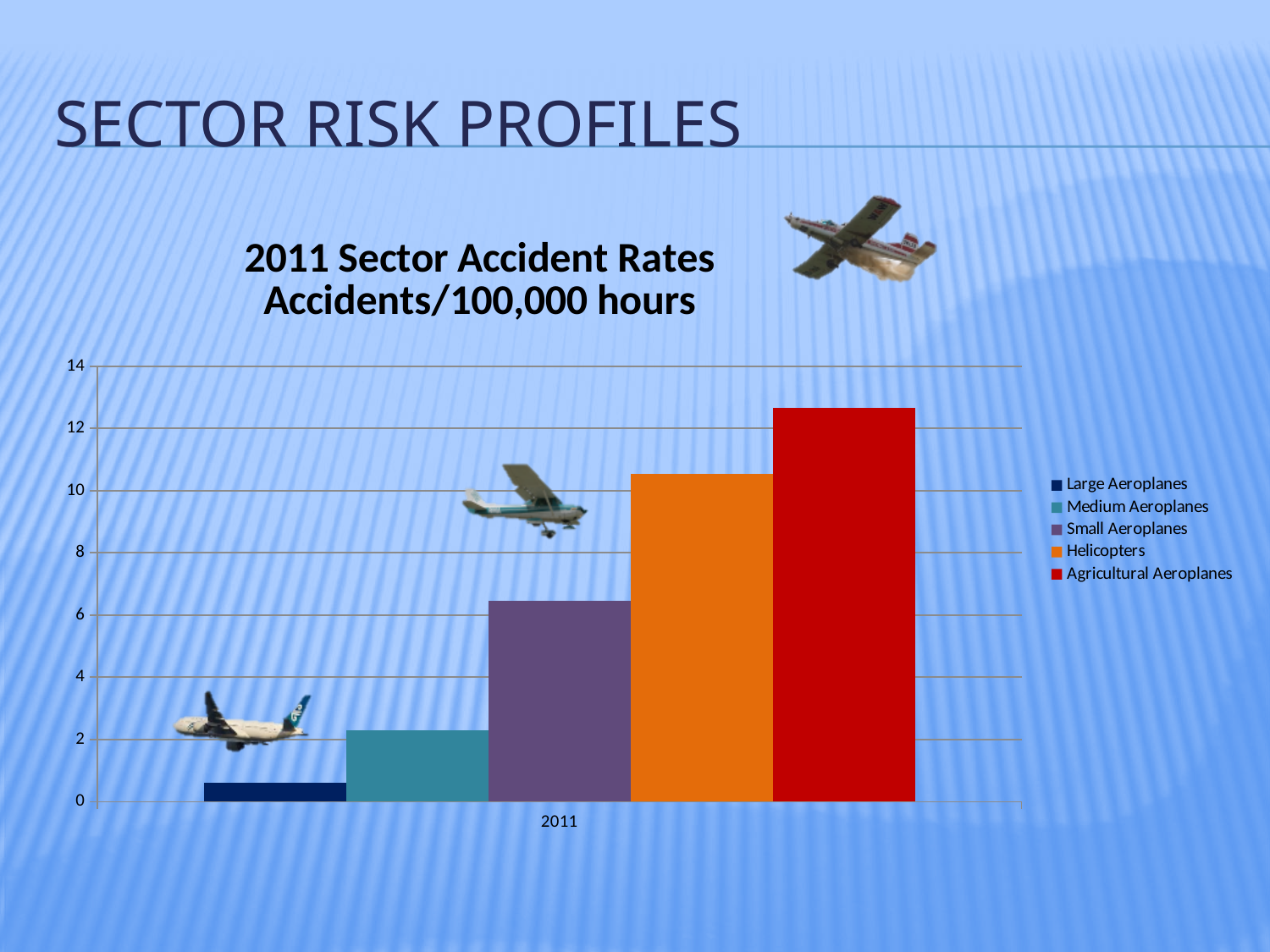
Is the value for Small Aeroplanes greater or less than 8? less How many series does the legend list? 5 Is the value for Helicopters greater or less than 10? greater What kind of chart is shown on the slide? bar chart Which series has the lowest accident rate in 2011? Large Aeroplanes Which is larger, the accident rate for Helicopters or for Small Aeroplanes? Helicopters How many categories are shown on the x axis? 1 What is the title of the chart? 2011 Sector Accident Rates Accidents/100,000 hours Which series has the highest accident rate in 2011? Agricultural Aeroplanes Is the value for Large Aeroplanes greater or less than 2? less Which is larger, the accident rate for Medium Aeroplanes or for Large Aeroplanes? Medium Aeroplanes